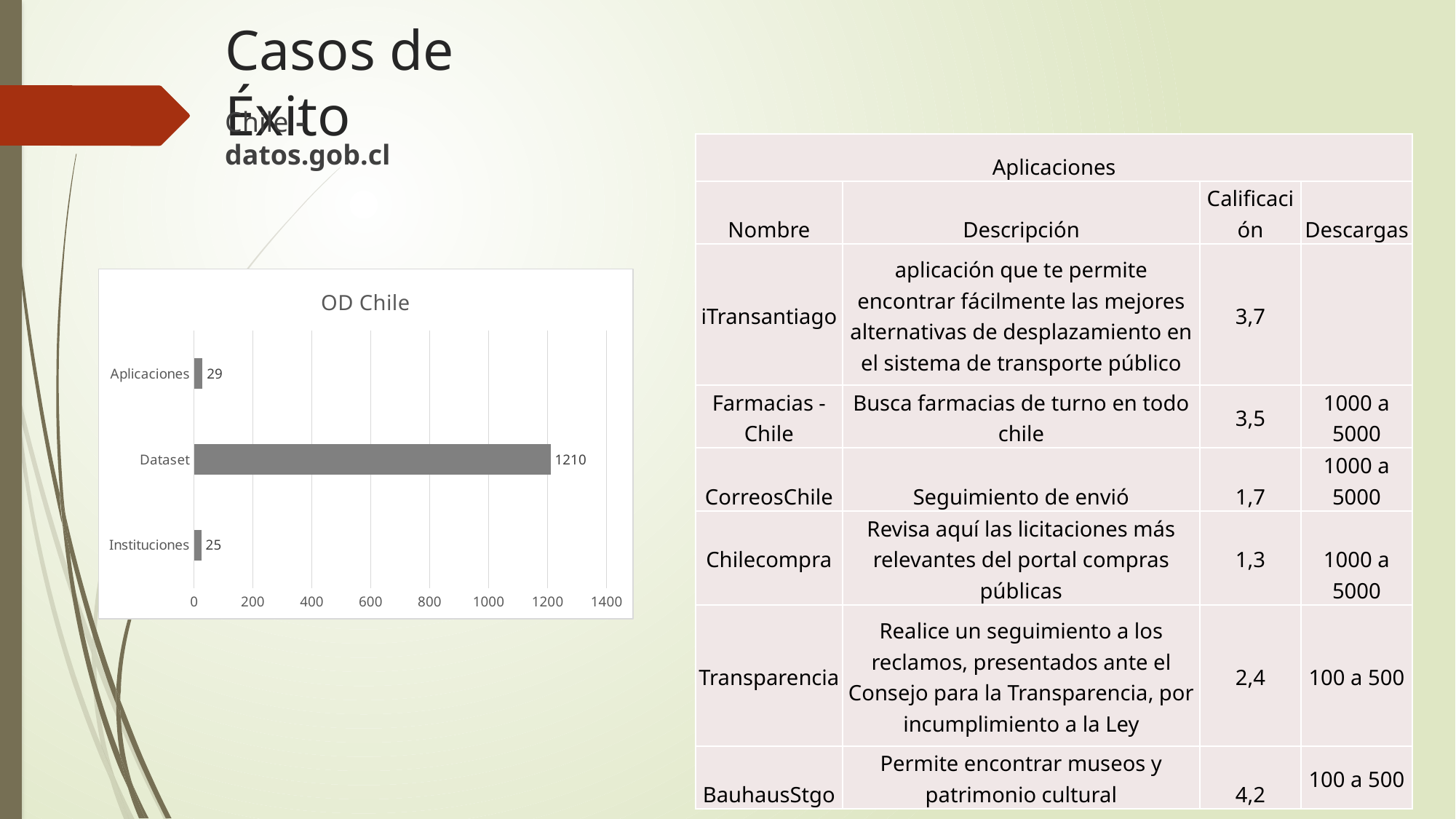
What is the value for Instituciones in the OD Chile chart? 25 Which category has the highest value in the OD Chile chart? Dataset What is the value for Aplicaciones in the OD Chile chart? 29 What is the difference between the Aplicaciones value and the Instituciones value in the OD Chile chart? 4 Which category has the lowest value in the OD Chile chart? Instituciones What is the difference between the Dataset value and the Aplicaciones value in the OD Chile chart? 1181 How many categories are shown in the OD Chile chart? 3 What kind of chart is the OD Chile chart? bar chart Which is larger in the OD Chile chart, Aplicaciones or Instituciones? Aplicaciones What is the title of the chart on the slide? OD Chile Is the value for Dataset in the OD Chile chart greater or less than 1000? greater What is the value for Dataset in the OD Chile chart? 1210